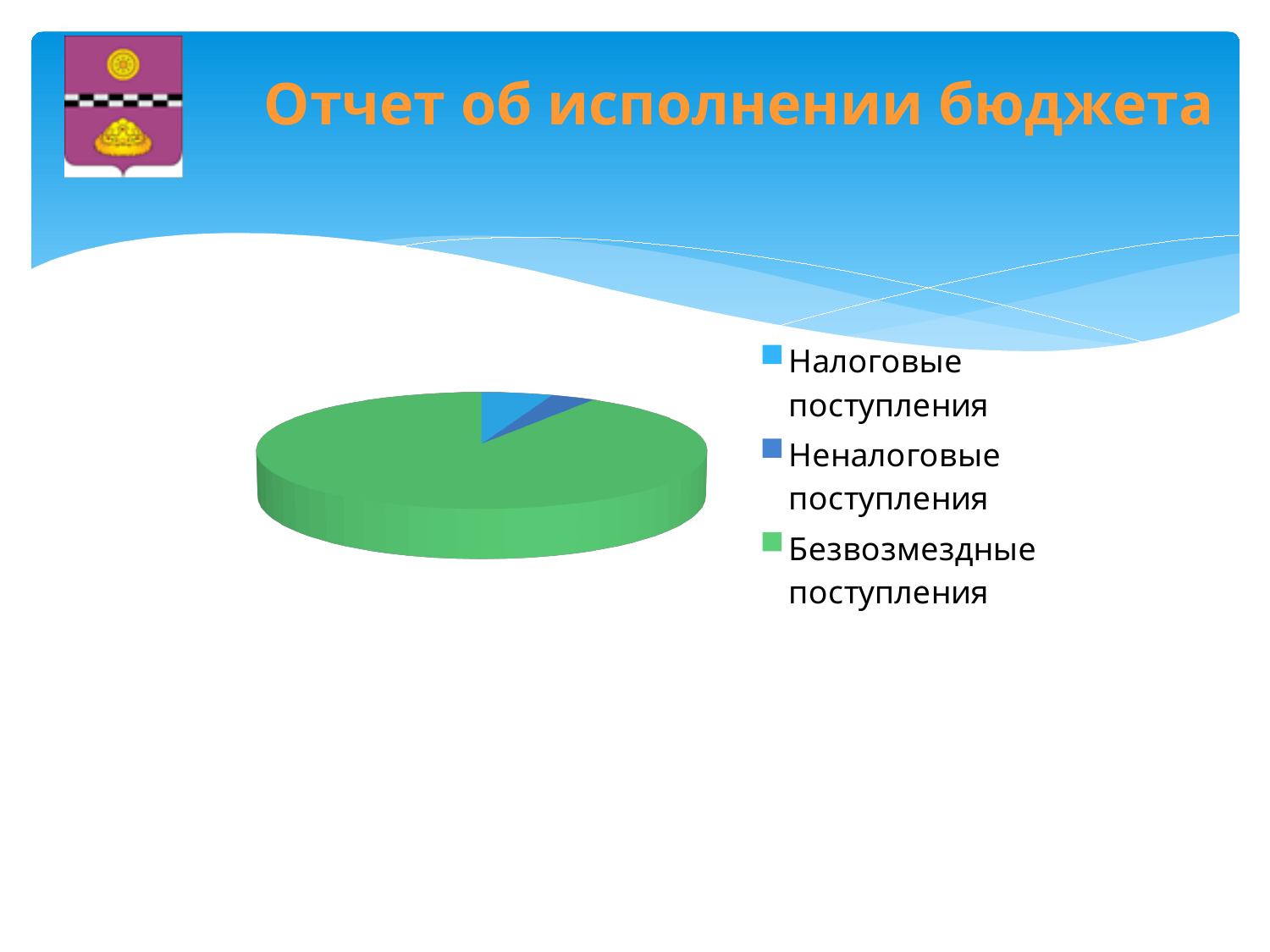
Which is larger in the pie chart: Неналоговые поступления or Безвозмездные поступления? Безвозмездные поступления What colour is the slice for Безвозмездные поступления in the pie chart? green What kind of chart is shown on the slide? pie chart How many slices does the pie chart have? 3 What is the title shown at the top of the slide above the pie chart? Отчет об исполнении бюджета How many entries does the legend of the pie chart list? 3 Which category has the largest slice in the pie chart? Безвозмездные поступления Which is larger in the pie chart: Безвозмездные поступления or Налоговые поступления? Безвозмездные поступления Does the slice for Безвозмездные поступления take up more or less than half of the pie? more